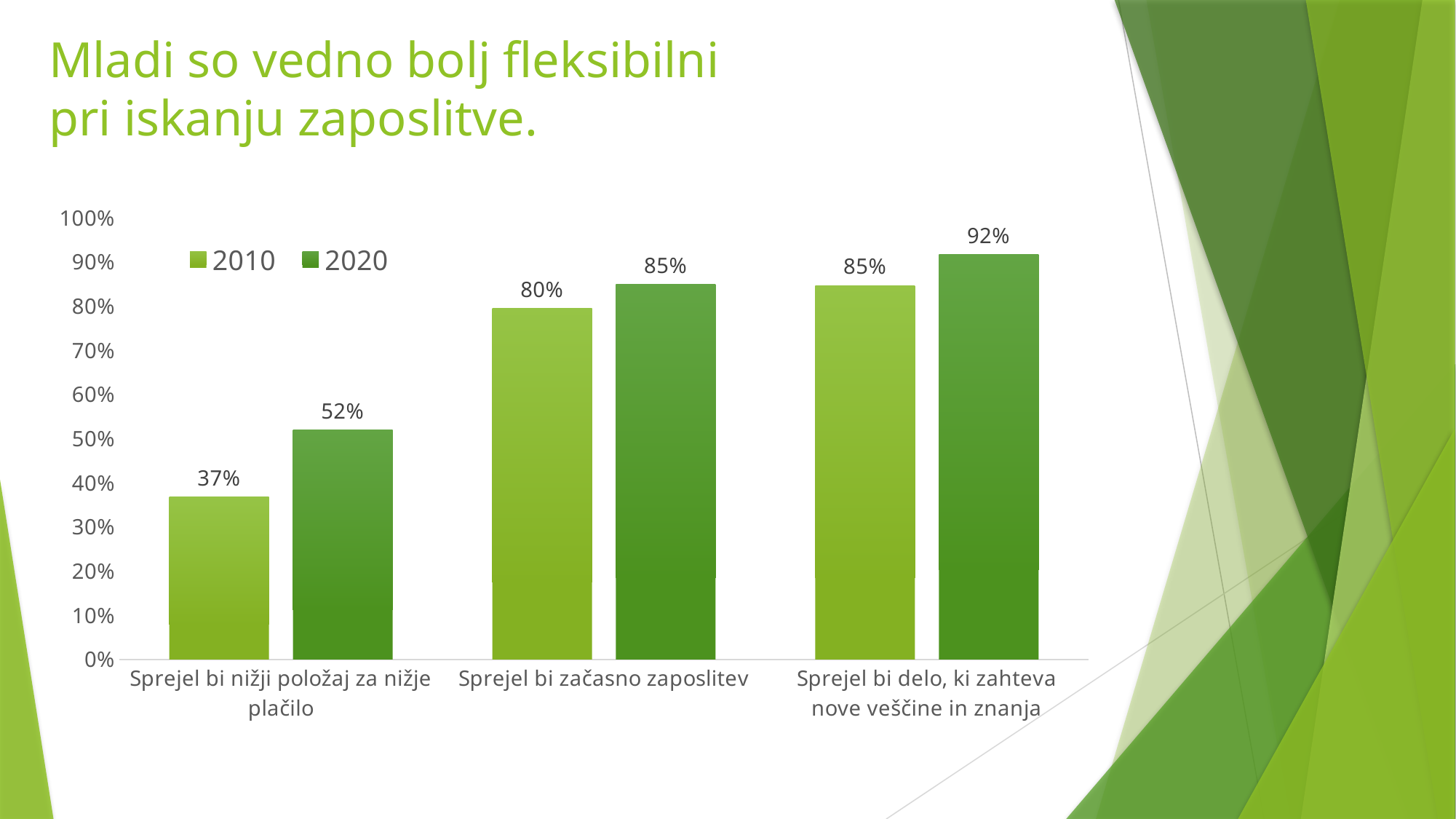
Which category has the highest 2020 value? Sprejel bi delo, ki zahteva nove veščine in znanja Which is larger for "Sprejel bi začasno zaposlitev": the 2010 value or the 2020 value? 2020 Is the 2010 value for "Sprejel bi delo, ki zahteva nove veščine in znanja" greater or less than 50%? greater What kind of chart is shown on the slide? bar chart What is the 2010 value for "Sprejel bi nižji položaj za nižje plačilo"? 37% How many categories are shown on the x axis? 3 What is the difference between the 2020 and 2010 values for "Sprejel bi nižji položaj za nižje plačilo"? 15% Which years are listed in the chart legend? 2010 and 2020 What is the 2020 value for "Sprejel bi začasno zaposlitev"? 85% How many series does the legend list? 2 Which category has the lowest 2010 value? Sprejel bi nižji položaj za nižje plačilo What is the 2020 value for "Sprejel bi delo, ki zahteva nove veščine in znanja"? 92%